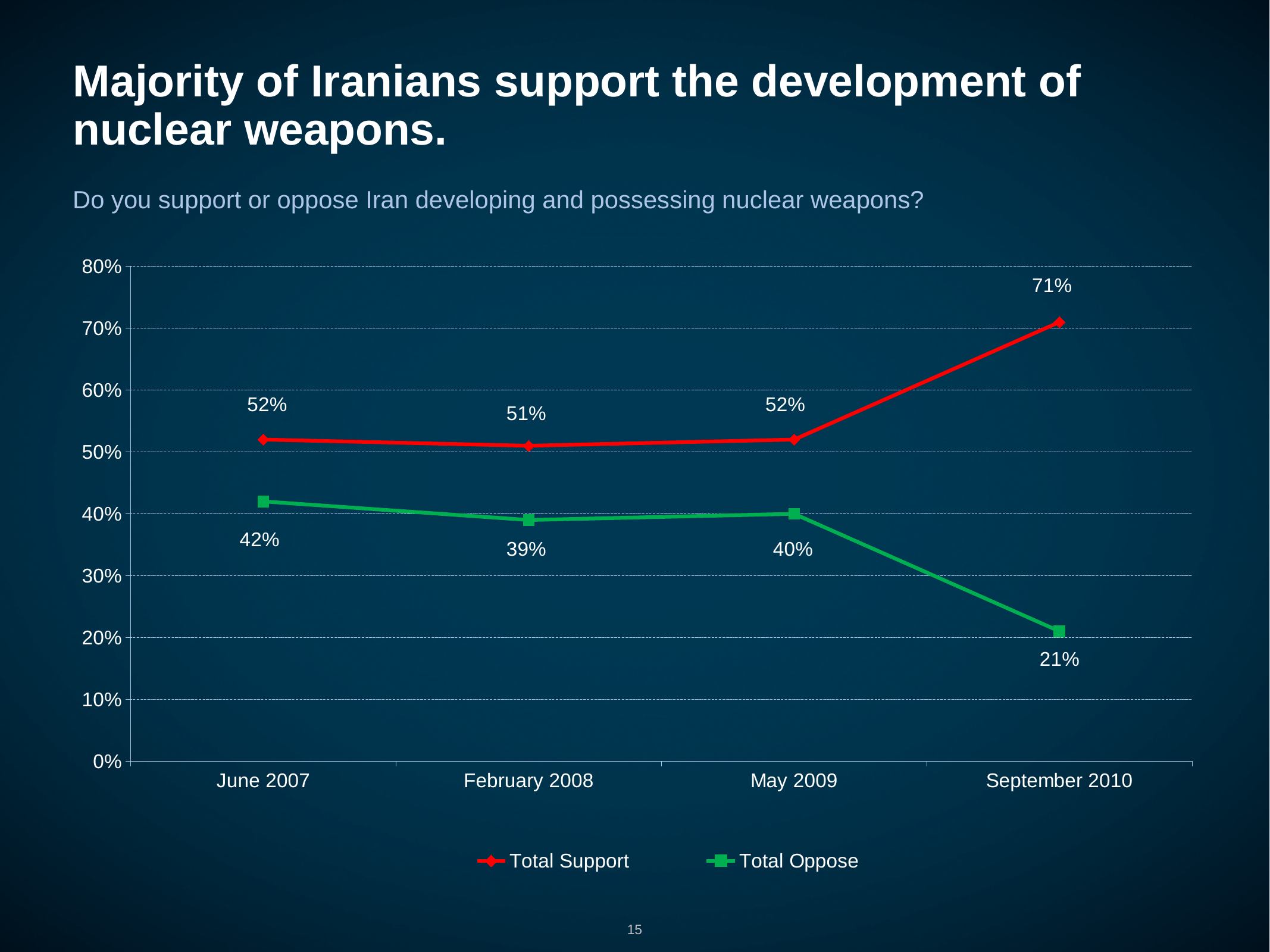
In which period is Total Oppose lowest? September 2010 What is the difference between Total Support and Total Oppose in September 2010? 50% Which is larger in May 2009, Total Support or Total Oppose? Total Support What is the difference between Total Support in May 2009 and February 2008? 1% In which period is Total Support highest? September 2010 How many series does the legend list? 2 What is the Total Support value for September 2010? 71% What kind of chart is shown on the slide? Line chart How many time periods are shown on the x axis? 4 What is the Total Oppose value for February 2008? 39% Does Total Oppose rise or fall from May 2009 to September 2010? Fall What is the Total Support value for June 2007? 52%